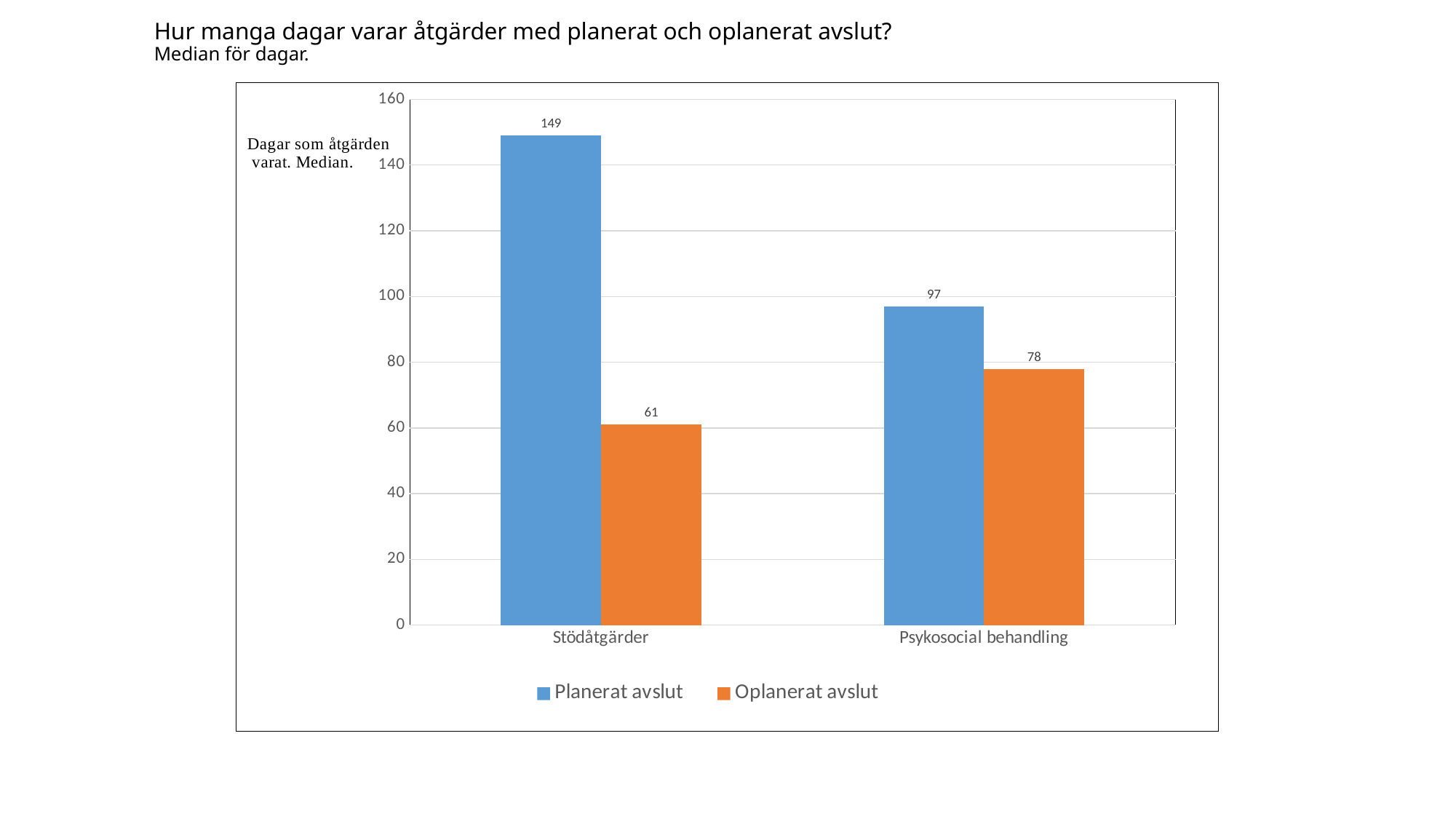
What is the value for Planerat avslut for Stödåtgärder? 149 What is the difference between Planerat avslut and Oplanerat avslut for Psykosocial behandling? 19 What is the difference between Planerat avslut and Oplanerat avslut for Stödåtgärder? 88 How many series does the legend list? 2 What is the value for Oplanerat avslut for Stödåtgärder? 61 Which is larger: Oplanerat avslut for Psykosocial behandling or Oplanerat avslut for Stödåtgärder? Oplanerat avslut for Psykosocial behandling Which category has the highest Planerat avslut value? Stödåtgärder What kind of chart is shown on the slide? Bar chart What is the value for Planerat avslut for Psykosocial behandling? 97 How many categories are shown on the x axis? 2 Which category has the lowest Oplanerat avslut value? Stödåtgärder What is the value for Oplanerat avslut for Psykosocial behandling? 78